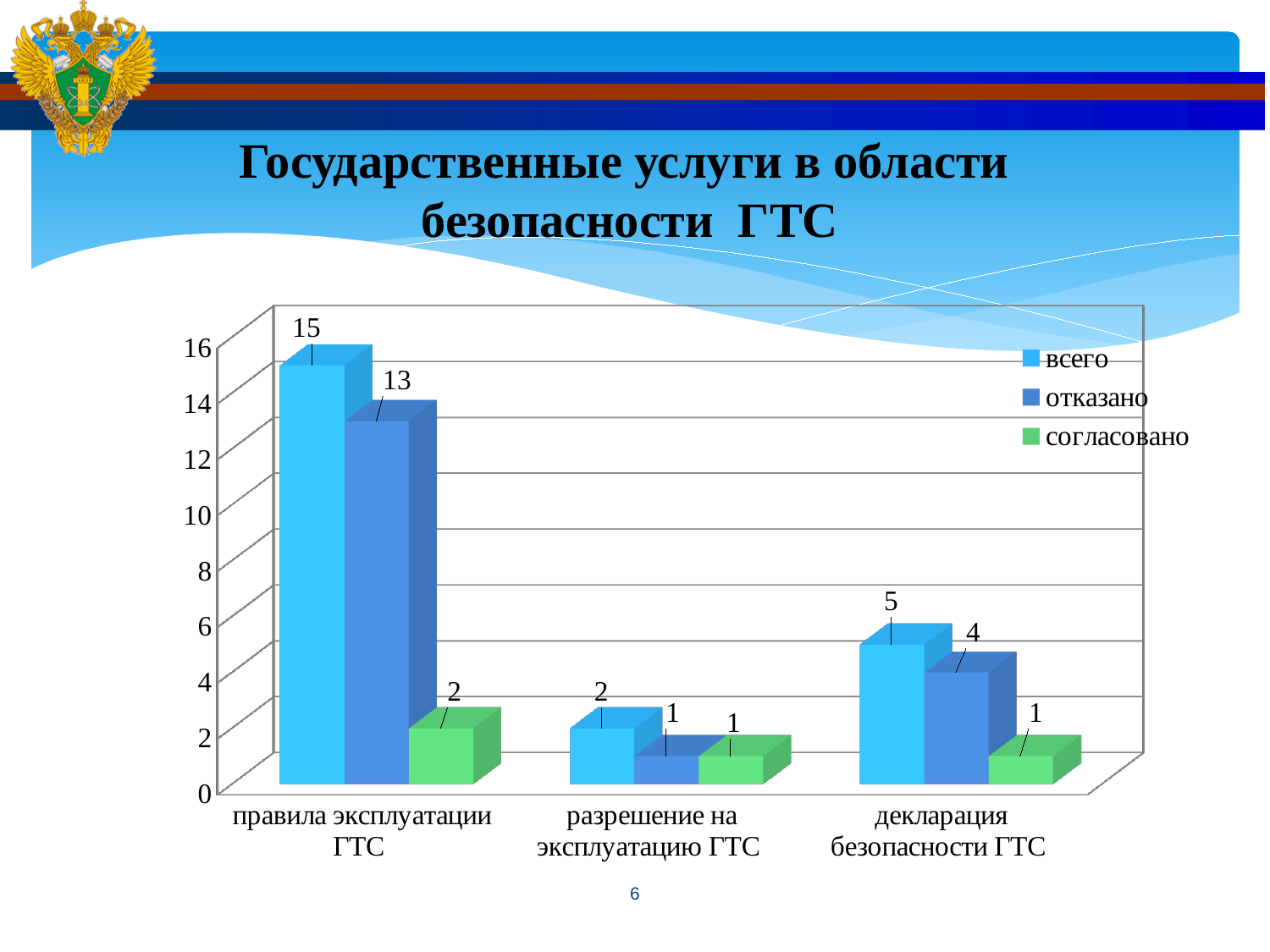
What is the difference between "всего" and "отказано" for "правила эксплуатации ГТС"? 2 What is the value of "согласовано" for "разрешение на эксплуатацию ГТС"? 1 Which series is shown in green in the legend? согласовано What kind of chart is shown on the slide? bar chart How many categories are shown on the x axis? 3 Which category has the lowest value for "отказано"? разрешение на эксплуатацию ГТС What is the value of "отказано" for "декларация безопасности ГТС"? 4 What is the title of the slide? Государственные услуги в области безопасности ГТС Which is larger for "декларация безопасности ГТС": "отказано" or "согласовано"? отказано Which category has the highest value for "всего"? правила эксплуатации ГТС How many series does the legend list? 3 What is the value of "всего" for "правила эксплуатации ГТС"? 15